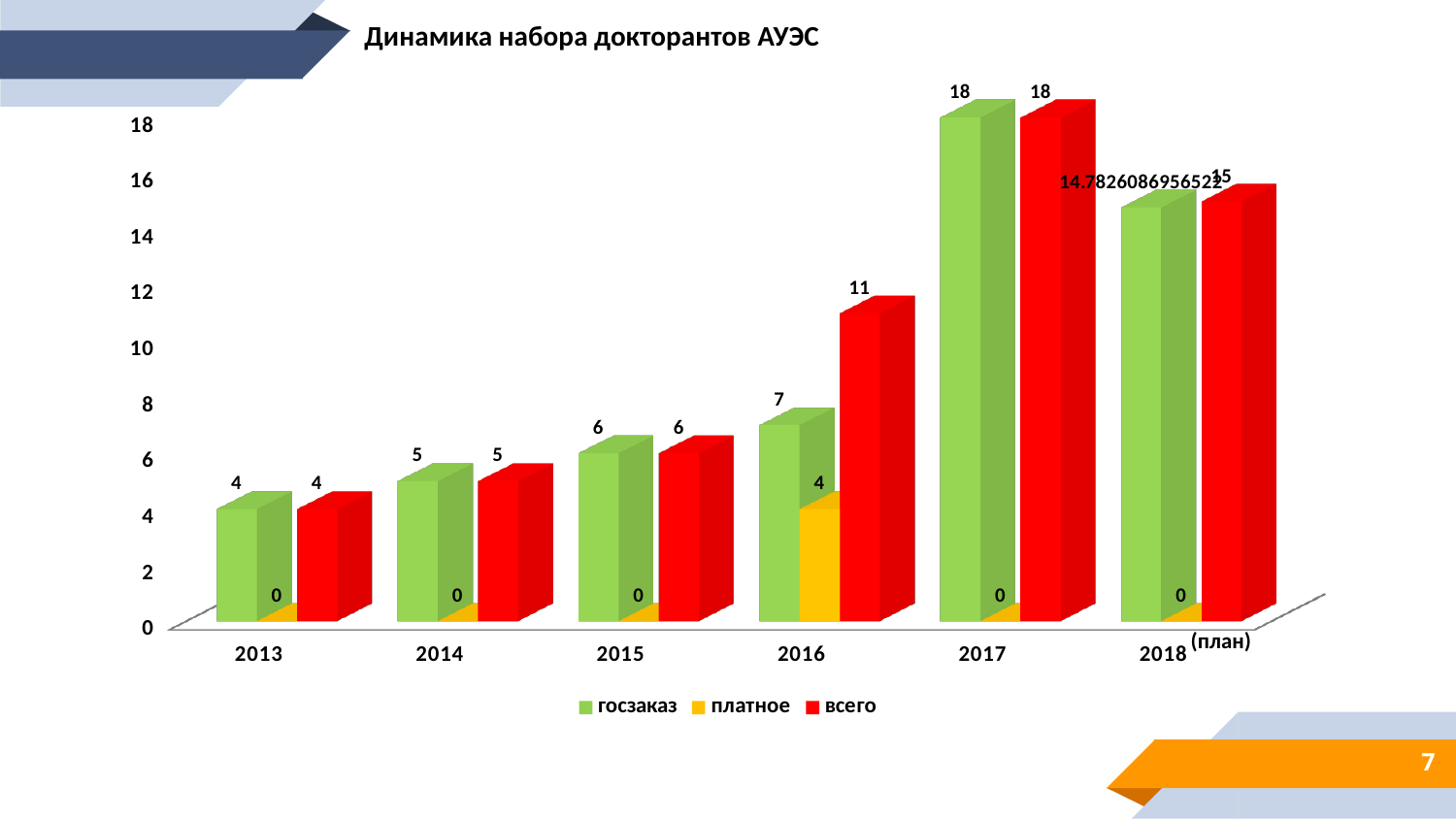
What is the value of всего for 2018 (план)? 15 What is the value of госзаказ for 2017? 18 What is the difference between всего in 2017 and всего in 2016? 7 What is the value of платное for 2016? 4 What is the value of всего for 2016? 11 Which is larger: госзаказ in 2015 or госзаказ in 2016? госзаказ in 2016 How many series does the legend list? 3 What type of chart is shown on the slide? bar chart In which year is the value of всего the highest? 2017 What is the title of the chart? Динамика набора докторантов АУЭС How many year categories are shown on the x axis? 6 In which year is the value of всего the lowest? 2013